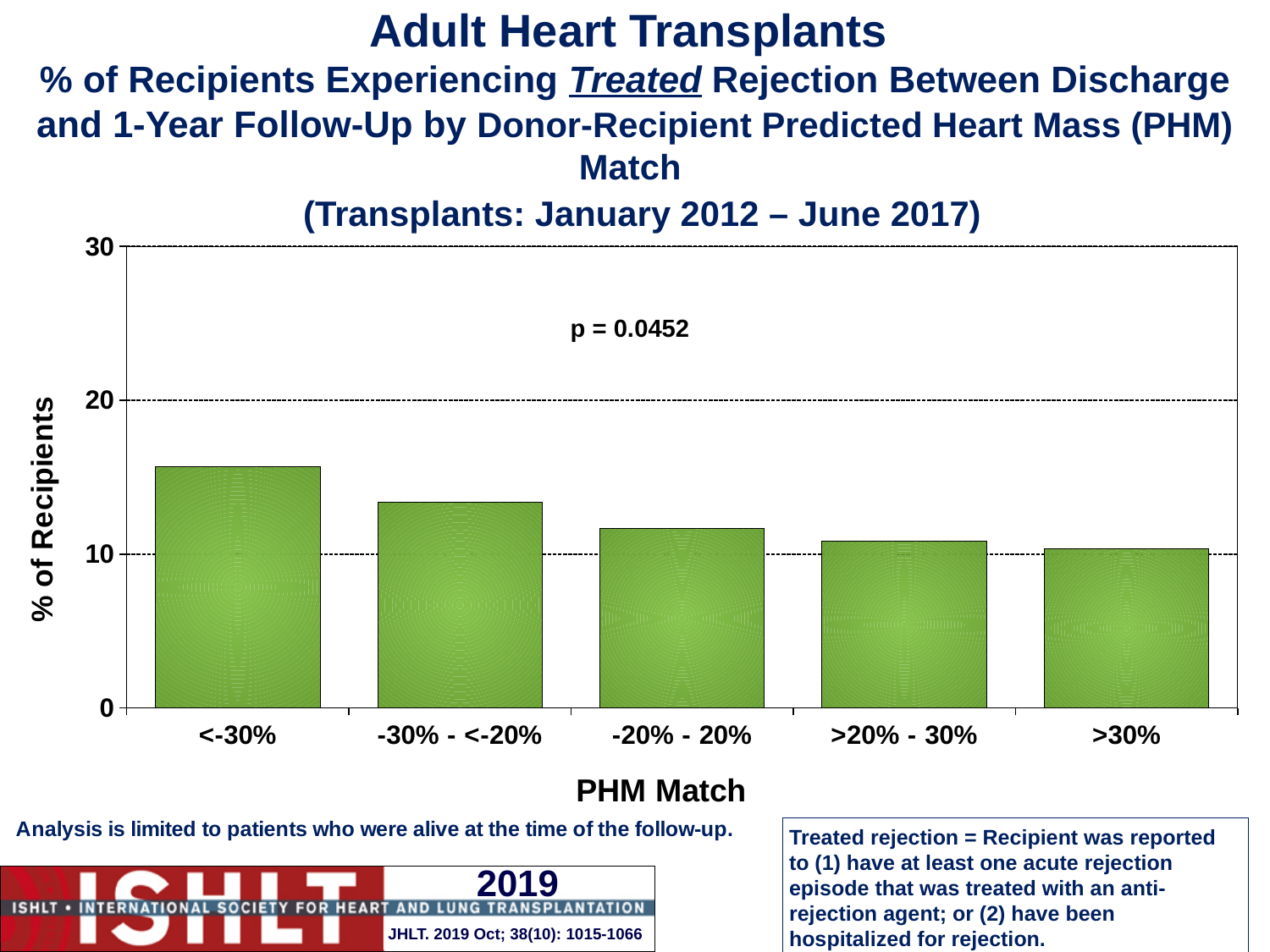
Is the value for the <-30% category greater or less than 20? less Which PHM Match category has the highest % of recipients experiencing treated rejection? <-30% Is the value for the >30% category greater or less than 20? less What kind of chart is shown on the slide? bar chart What p-value is printed on the chart? p = 0.0452 Is the value for the -30% - <-20% category greater or less than 10? greater Do the bar values rise or fall moving from left to right along the x axis? fall Which PHM Match category has the lowest % of recipients experiencing treated rejection? >30% Which has a larger value: the <-30% category or the -20% - 20% category? <-30% How many PHM Match categories are plotted on the x axis? 5 What is the label of the y axis? % of Recipients